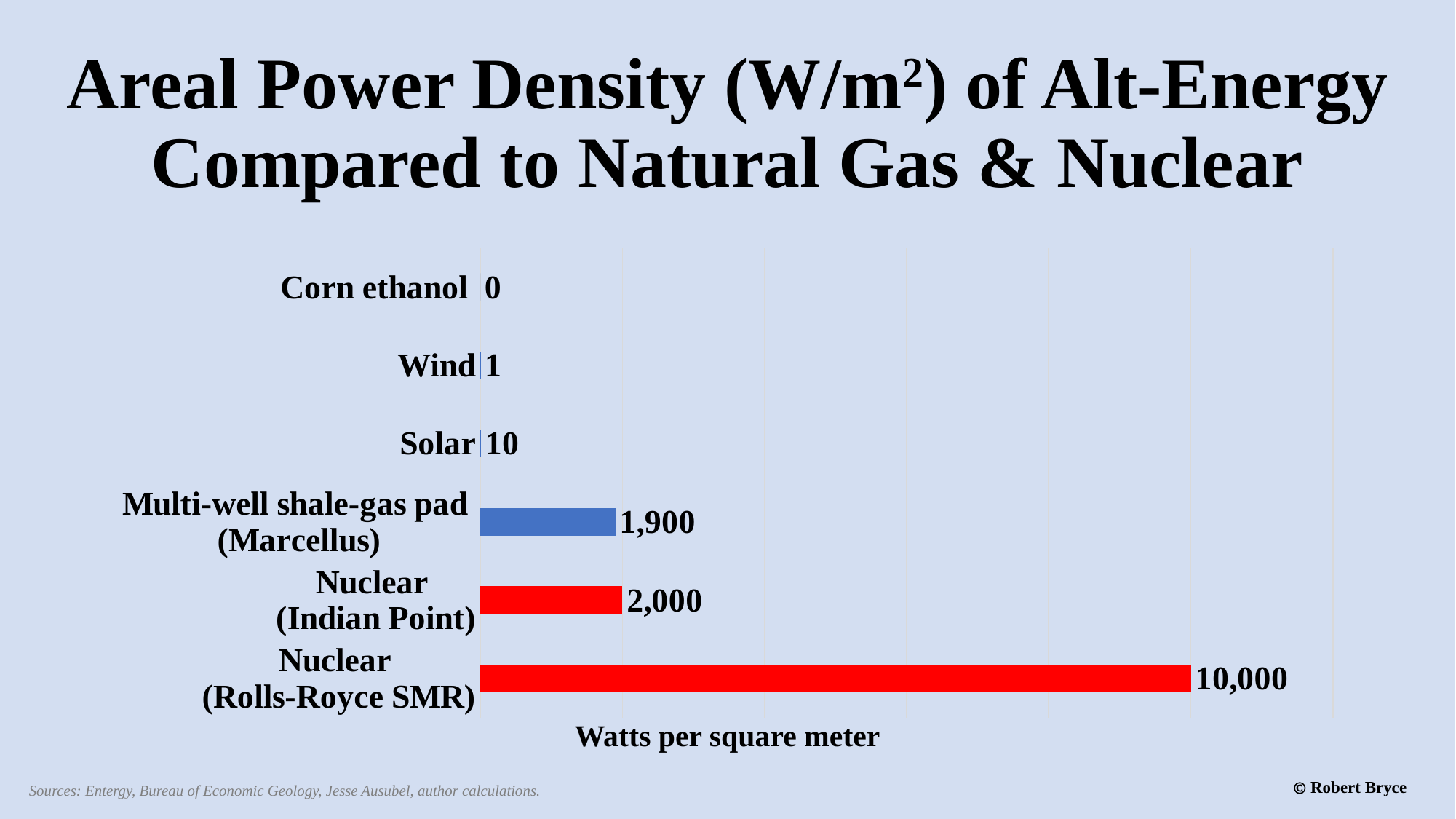
How many categories are shown in the chart? 6 What value is shown for Wind? 1 Which is larger, the value for Solar or the value for Wind? Solar What is the label on the horizontal axis of the chart? Watts per square meter Which category has the lowest areal power density? Corn ethanol Which category has the highest areal power density? Nuclear (Rolls-Royce SMR) What value is shown for Nuclear (Indian Point)? 2,000 What is the difference between the values for Nuclear (Rolls-Royce SMR) and Nuclear (Indian Point)? 8,000 What is the difference between the values for Nuclear (Indian Point) and the Multi-well shale-gas pad (Marcellus)? 100 What kind of chart is shown on the slide? Bar chart What is the areal power density value shown for Solar? 10 What value is shown for the Multi-well shale-gas pad (Marcellus)? 1,900